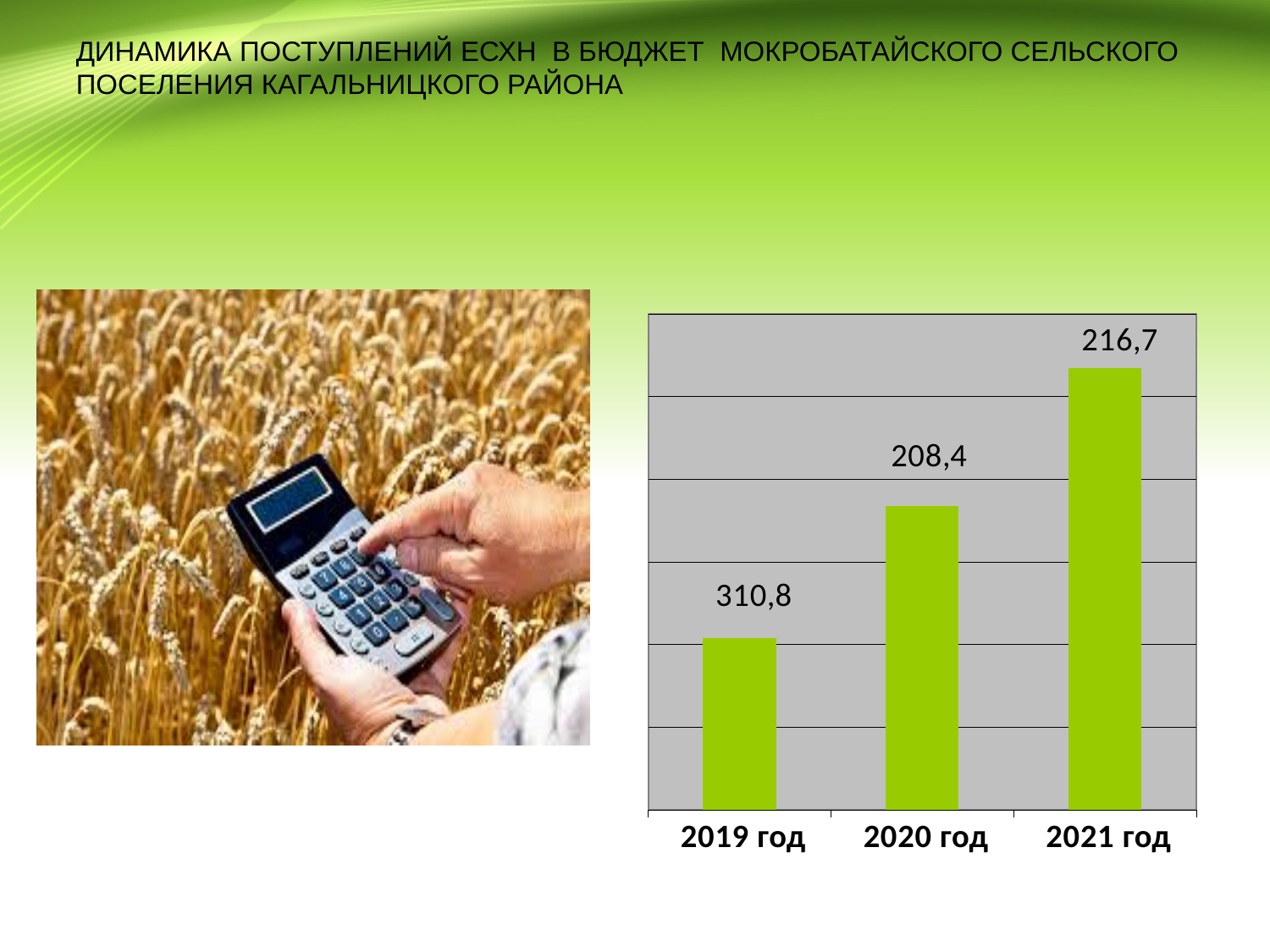
What is the difference between the labelled values for 2021 год and 2020 год? 8,3 What colour are the bars in the chart? green Which year is the first category on the x axis of the chart? 2019 год What is the value shown for 2019 год? 310,8 What is the value shown for 2020 год? 208,4 How many categories (years) are shown on the chart? 3 What is the value shown for 2021 год? 216,7 What is the difference between the labelled values for 2019 год and 2020 год? 102,4 What kind of chart is shown on the slide? bar chart